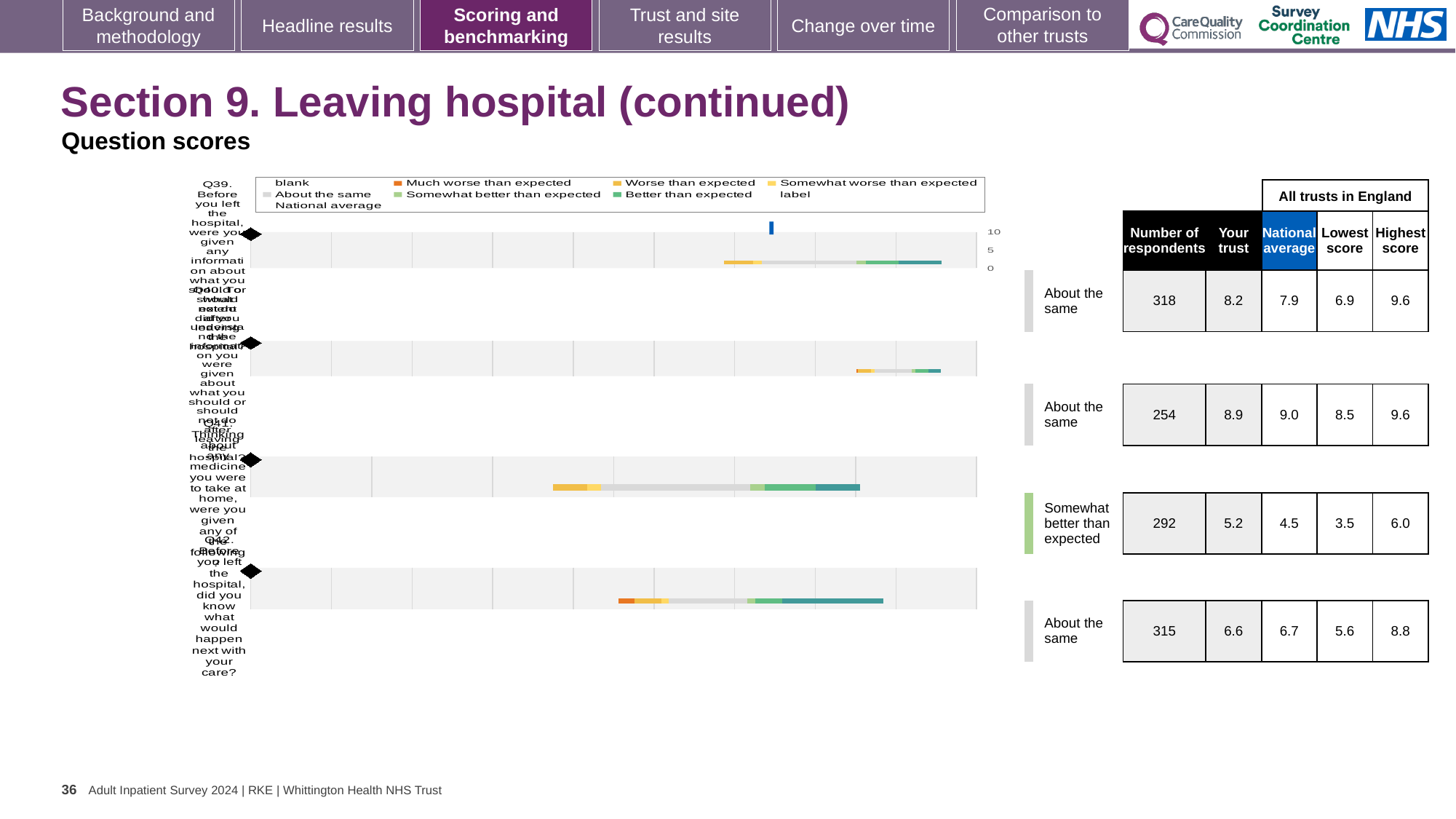
In the chart legend, what colour represents 'Much worse than expected'? orange In the table beside the chart, which row has the highest 'Your trust' score? second row (Q40), 8.9 In the table beside the chart, which row has the lowest number of respondents? second row (Q40), 254 How many entries does the chart legend list? 9 What kind of chart is shown on the slide? bar chart In the table beside the chart, what is the difference between the 'Your trust' score and the national average for the third row (Q41)? 0.7 How many question rows (bars) are plotted in the chart? 4 In the table beside the chart, what is the national average for the fourth row (Q42)? 6.7 In the table beside the chart, what is the 'Your trust' score for the first row (Q39)? 8.2 In the table beside the chart, what is the number of respondents for the third row (Q41)? 292 In the chart legend, what colour represents 'About the same'? grey In the table beside the chart, for the third row (Q41), which is larger: the 'Your trust' score or the national average? Your trust